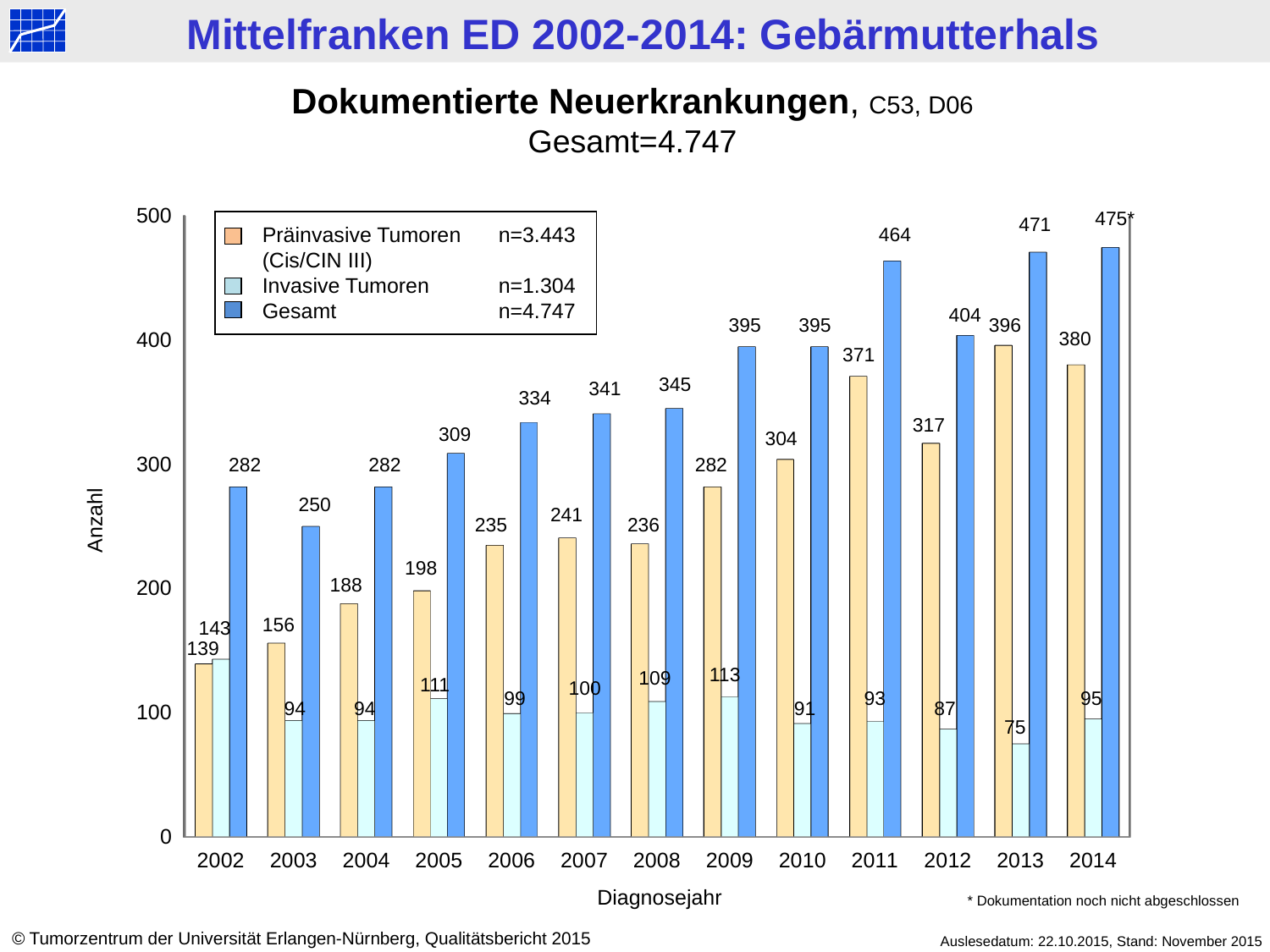
What is the difference between the Gesamt values for 2014 and 2002? 193 What kind of chart is shown on the slide? bar chart Is the Gesamt value for 2009 greater or less than 300? greater How many years are shown on the x axis? 13 Which is larger, the Präinvasive Tumoren value in 2012 or in 2013? 2013 In which year is the Invasive Tumoren value lowest? 2013 What is the value for Präinvasive Tumoren in 2013? 396 What is the value for Invasive Tumoren in 2005? 111 In which year is the Gesamt value highest? 2014 How many series does the legend list? 3 What total n does the legend give for Invasive Tumoren? n=1.304 What is the Gesamt value for 2011? 464